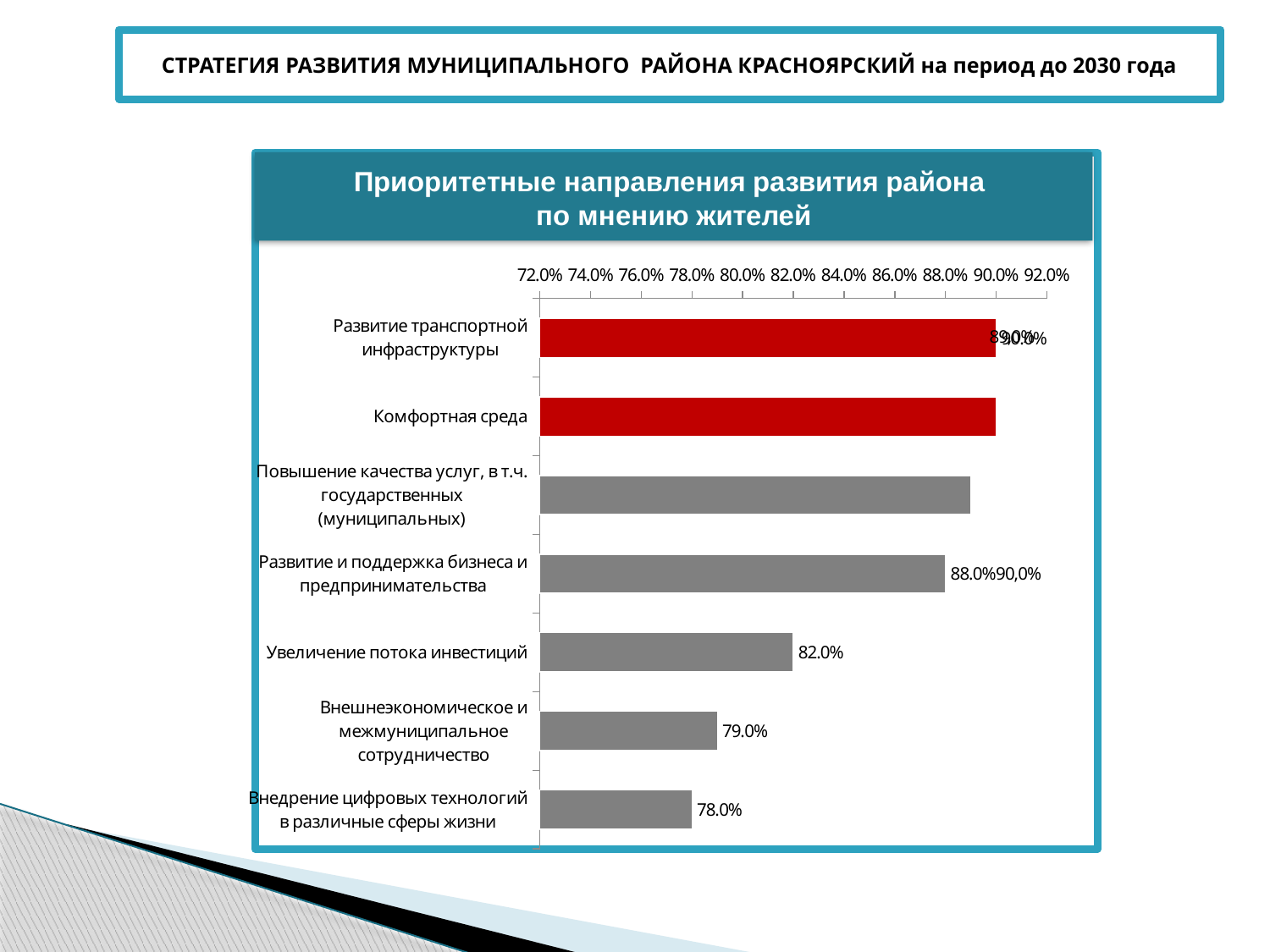
What is the title of the chart? Приоритетные направления развития района по мнению жителей Which is larger: the value for Увеличение потока инвестиций or for Внешнеэкономическое и межмуниципальное сотрудничество? Увеличение потока инвестиций What kind of chart is shown on the slide? bar chart What is the difference between the values for Увеличение потока инвестиций and Внедрение цифровых технологий в различные сферы жизни? 4.0 percentage points Is the value for Комфортная среда greater or less than 86.0%? greater What is the value for Внешнеэкономическое и межмуниципальное сотрудничество? 79.0% What is the value for Развитие и поддержка бизнеса и предпринимательства? 88.0% Is the value for Повышение качества услуг, в т.ч. государственных (муниципальных) greater or less than 84.0%? greater How many categories are shown in the chart? 7 What is the value for Увеличение потока инвестиций? 82.0% What is the value for Внедрение цифровых технологий в различные сферы жизни? 78.0% Which category has the lowest value? Внедрение цифровых технологий в различные сферы жизни